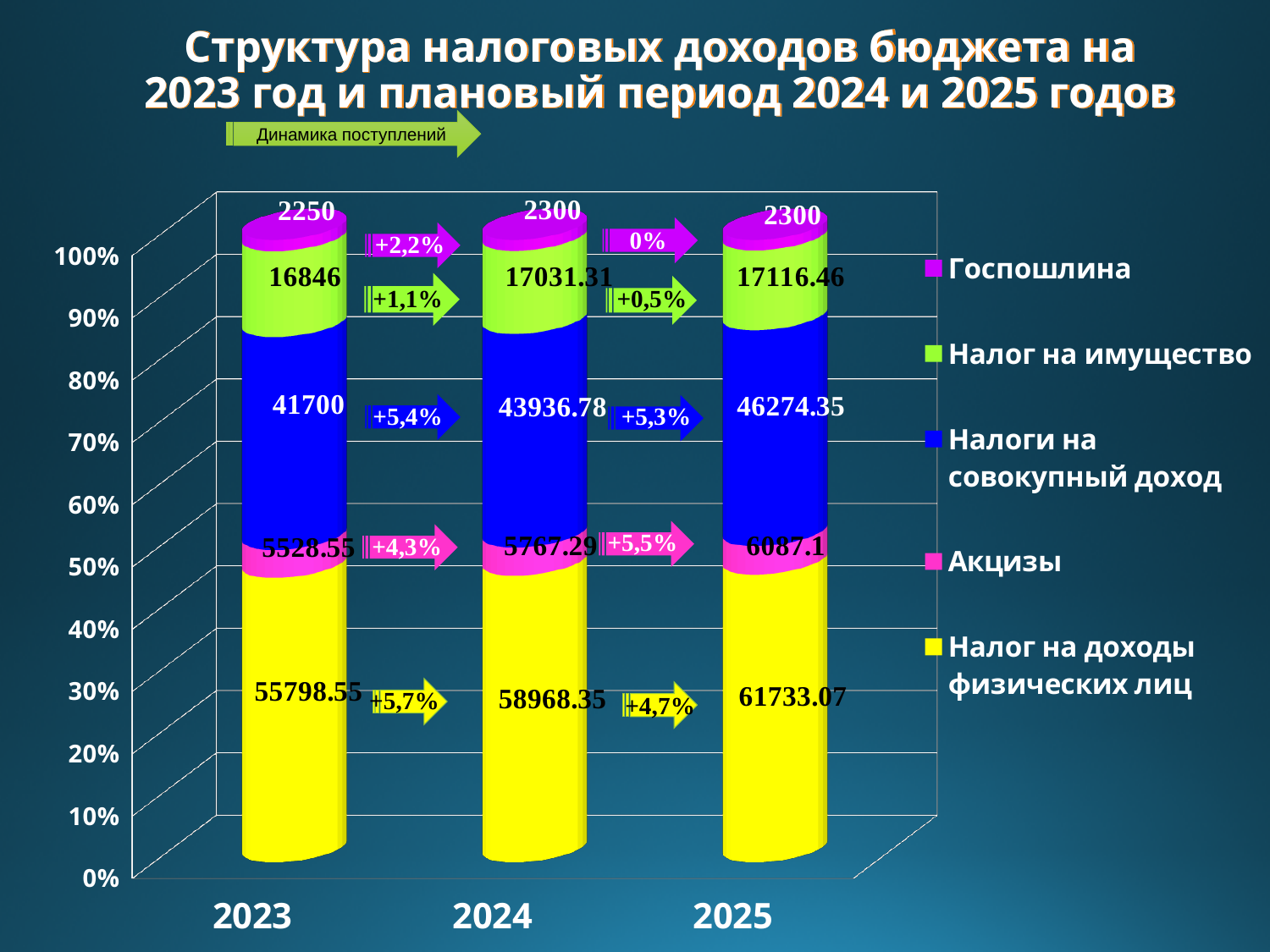
Which is larger in 2025: the value for Акцизы or the value for Госпошлина? Акцизы What is the value for Налог на доходы физических лиц in 2023? 55798.55 What is the difference between the Налоги на совокупный доход values for 2024 and 2023? 2236.78 How many series does the legend list? 5 In which year is the value for Налог на доходы физических лиц the lowest? 2023 What is the value for Госпошлина in 2023? 2250 What is the value for Акцизы in 2024? 5767.29 What is the total of all segments in the 2024 bar? 128003.73 In which year is the value for Налог на имущество the highest? 2025 What kind of chart is shown on the slide? Stacked bar chart What is the value for Налоги на совокупный доход in 2025? 46274.35 How many years are shown on the x axis? 3